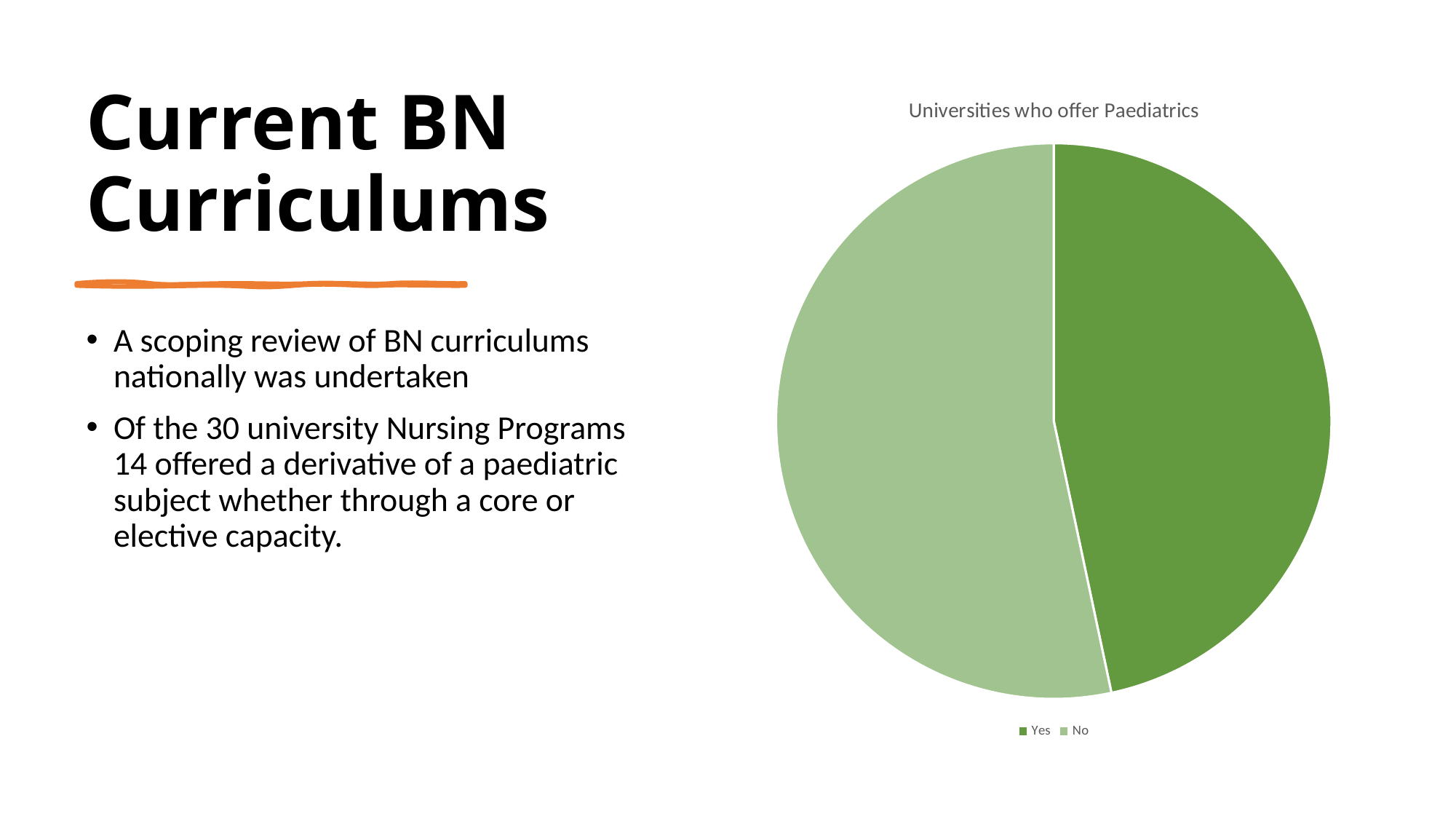
What is the title of the pie chart? Universities who offer Paediatrics Which category has the largest slice in the pie chart? No How many entries does the legend of the pie chart list? 2 What are the two categories shown in the pie chart's legend? Yes and No How many slices does the pie chart have? 2 Which slice of the pie chart is larger, Yes or No? No What kind of chart is shown on the slide? pie chart Which category has the smallest slice in the pie chart? Yes